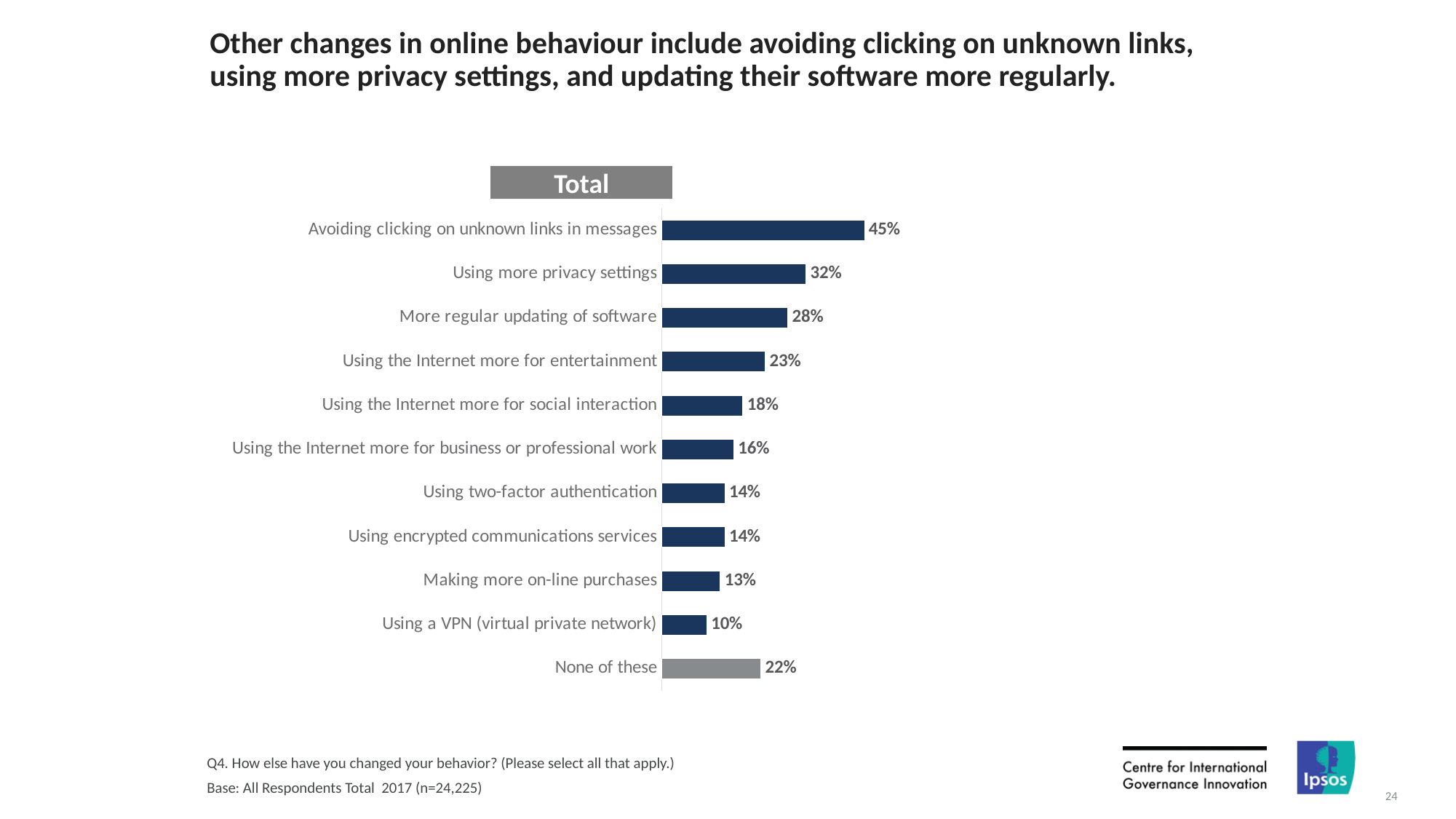
What is the difference between 'More regular updating of software' and 'Making more on-line purchases'? 15 percentage points What is the difference between 'Avoiding clicking on unknown links in messages' and 'Using more privacy settings'? 13 percentage points What kind of chart is shown on the slide? Bar chart What is the value for 'Using more privacy settings'? 32% What is the value for 'Using a VPN (virtual private network)'? 10% What percentage of respondents reported avoiding clicking on unknown links in messages? 45% How many categories are shown in the chart? 11 Which is larger: 'Using the Internet more for entertainment' or 'Using the Internet more for social interaction'? Using the Internet more for entertainment Which category has the lowest value? Using a VPN (virtual private network) Which category has the highest value? Avoiding clicking on unknown links in messages What percentage of respondents selected 'None of these'? 22% What is the label shown in the box above the chart? Total